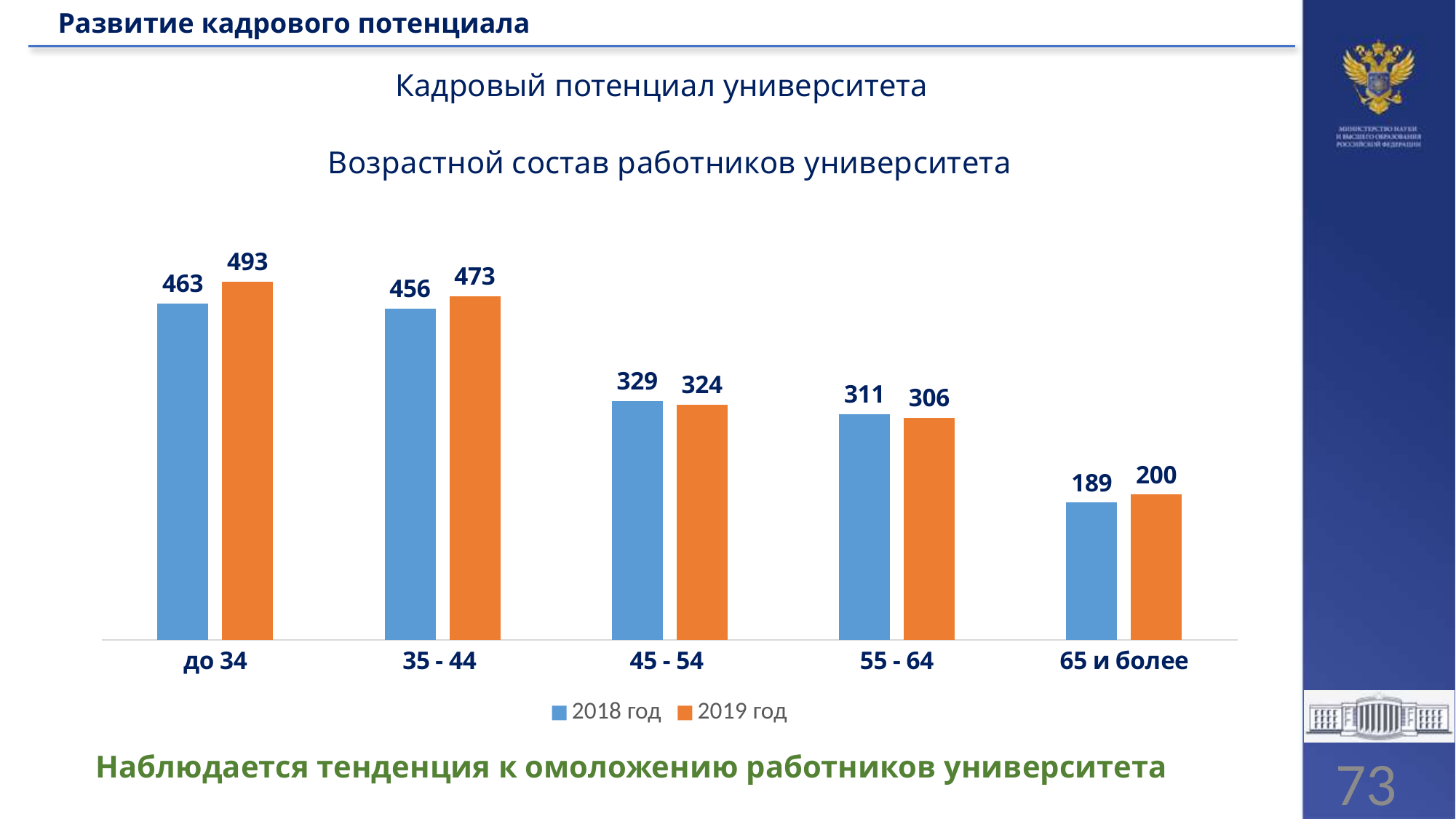
How many series does the legend list? 2 What is the value for the 2019 год series in the до 34 age group? 493 What is the difference between the 2019 год and 2018 год values for the 35 - 44 age group? 17 What is the value for the 2018 год series in the 45 - 54 age group? 329 What kind of chart is shown on the slide? Bar chart How many age groups are shown on the x axis? 5 Which age group has the highest value for 2019 год? до 34 What is the difference between the 2018 год and 2019 год values for the 55 - 64 age group? 5 Do the 2018 год values rise or fall from the до 34 group to the 65 и более group? Fall Which age group has the lowest value for 2018 год? 65 и более What is the value for the 2019 год series in the 65 и более age group? 200 Which is larger for the 45 - 54 age group: the 2018 год value or the 2019 год value? 2018 год